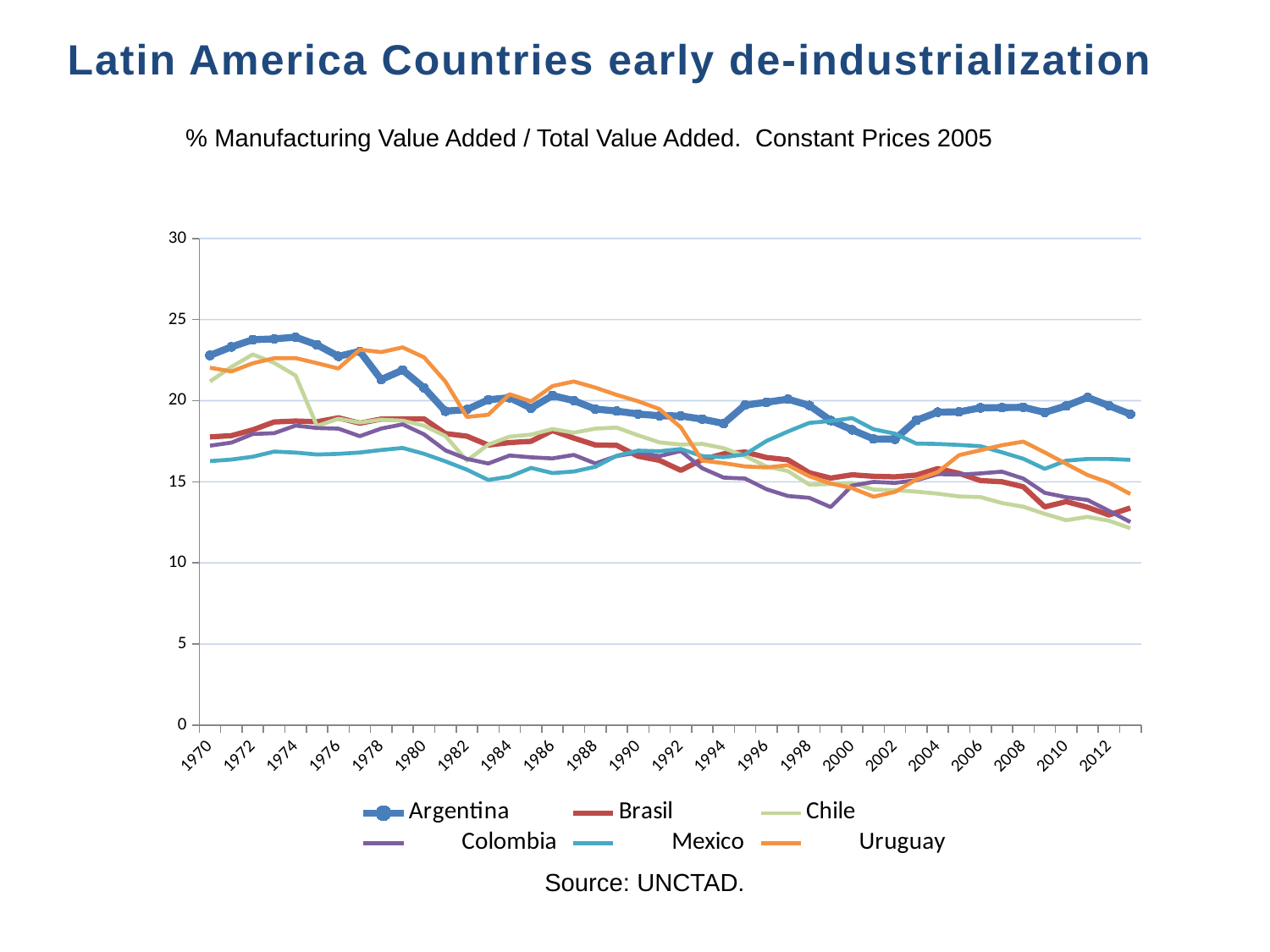
In 1970, which is larger, the value for Argentina or the value for Mexico? Argentina Is the value for Chile in 2012 greater or less than 15? less Is the value for Argentina in 1970 greater or less than 20? greater Is the value for Mexico in 1970 greater or less than 20? less How many series does the legend list? 6 Does the Uruguay series rise or fall overall from 1970 to the end of the period? fall Which series has the highest value at the end of the period (2013)? Argentina What source is cited below the chart? UNCTAD Does the Argentina series rise or fall overall from 1970 to the end of the period? fall What kind of chart is shown on the slide? line chart What is the title of the slide's chart? Latin America Countries early de-industrialization